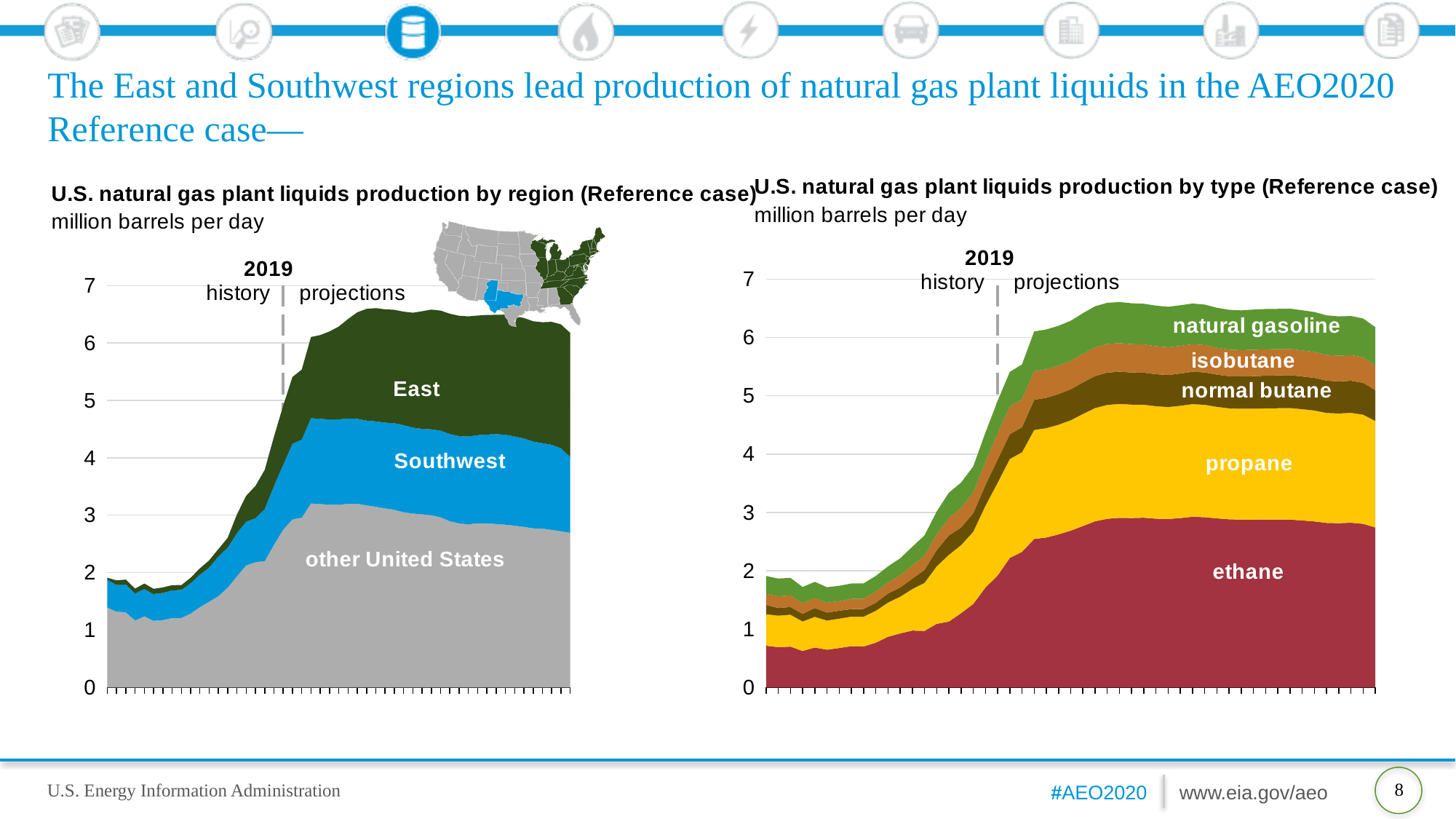
What unit is used on the y axis of the right chart, 'U.S. natural gas plant liquids production by type'? million barrels per day In the left chart by region, is the 'other United States' production at the end of the projection period greater or less than 3 million barrels per day? less In the right chart by type, which product type is the largest during the projection period? ethane In the right chart by type, does total natural gas plant liquids production rise or fall from the start of the history period to the end of the projection period? rise How many regions are shown as series in the left chart, 'U.S. natural gas plant liquids production by region'? 3 How many product types are shown as series in the right chart, 'U.S. natural gas plant liquids production by type'? 5 In the left chart by region, which year separates history from projections? 2019 In the right chart by type, is ethane production at the end of the projection period greater or less than 3 million barrels per day? less What kind of chart is the left chart, 'U.S. natural gas plant liquids production by region (Reference case)'? stacked area chart In the right chart by type, is total production at the start of the history period greater or less than 2 million barrels per day? less In the left chart by region, which region contributes the largest share of production during the projection period? other United States